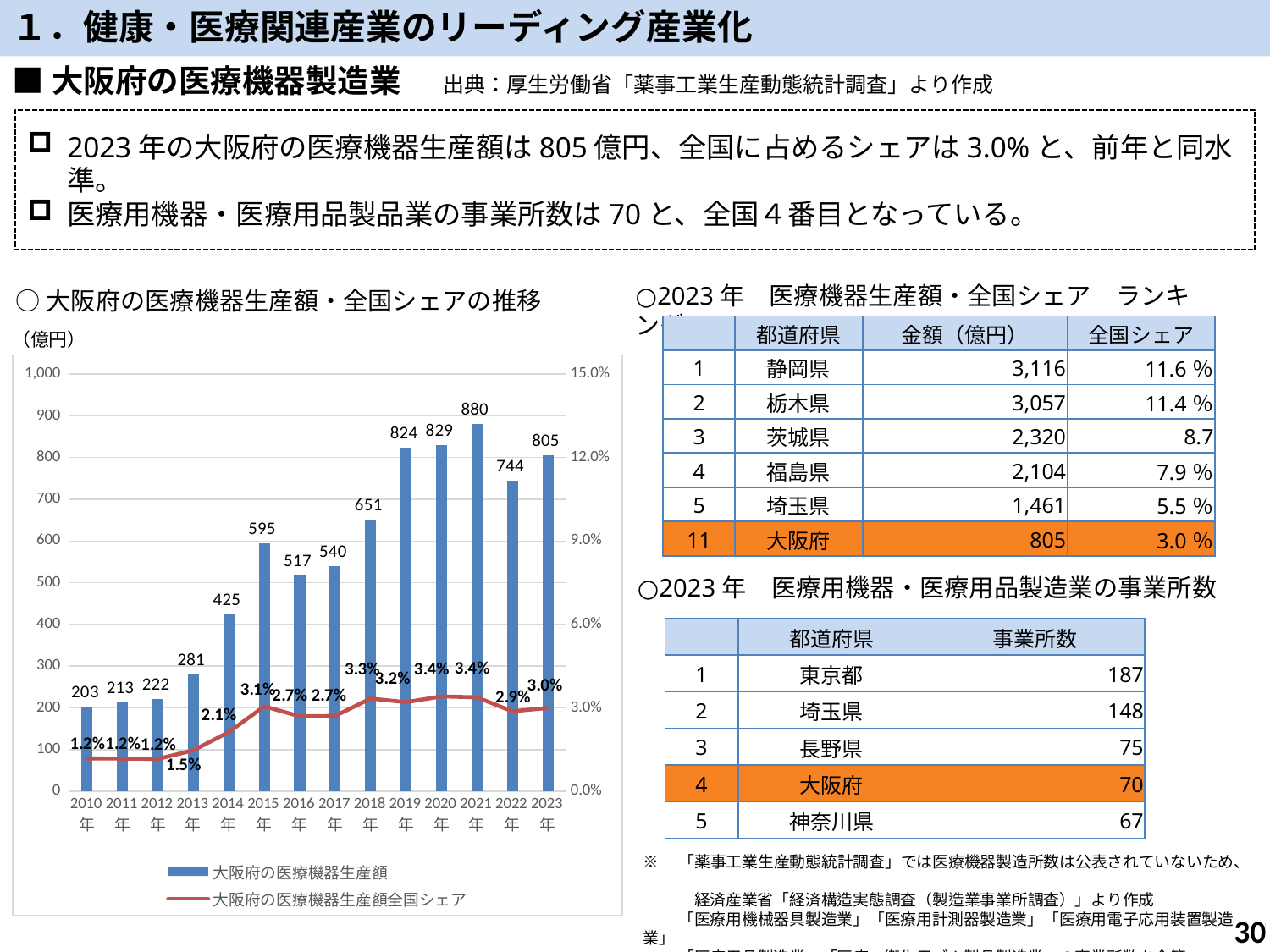
What is the value of 大阪府の医療機器生産額全国シェア for 2015年 in the chart? 3.1% Is the 大阪府の医療機器生産額 for 2014年 greater or less than 400? greater How many series does the chart legend list? 2 What kind of chart is used to show 大阪府の医療機器生産額・全国シェアの推移? Combined bar and line chart How many years are shown on the x axis of the chart? 14 Did the 大阪府の医療機器生産額 rise or fall from 2010年 to 2015年? Rise Which year has the lowest 大阪府の医療機器生産額 in the chart? 2010年 Which year has the highest 大阪府の医療機器生産額 in the chart? 2021年 Which is larger, the 大阪府の医療機器生産額 for 2016年 or for 2017年? 2017年 What is the unit shown above the left axis of the chart? 億円 What is the value of 大阪府の医療機器生産額 for 2023年 in the chart? 805 What is the difference between the 大阪府の医療機器生産額 values for 2021年 and 2022年? 136